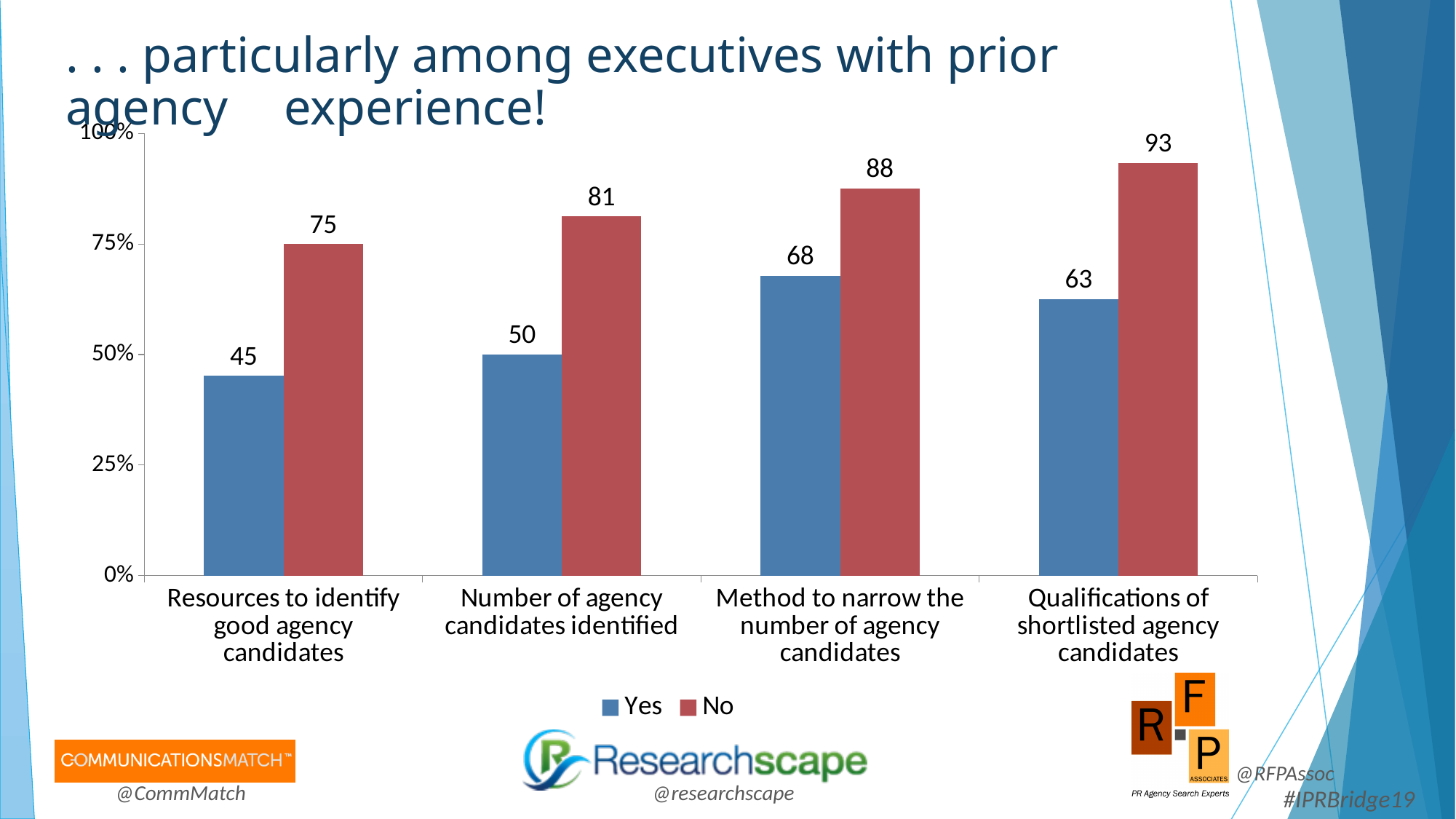
Is the "Yes" value for "Number of agency candidates identified" greater or less than 75%? less What colour are the "No" bars? red How many categories are shown on the x axis? 4 What is the difference between the "No" and "Yes" values for "Number of agency candidates identified"? 31 What is the value for "No" for "Method to narrow the number of agency candidates"? 88 Which category has the highest "Yes" value? Method to narrow the number of agency candidates What is the value for "No" for "Qualifications of shortlisted agency candidates"? 93 How many series does the legend list? 2 What is the value for "Yes" for "Resources to identify good agency candidates"? 45 What kind of chart is shown on the slide? bar chart Which is larger for "Qualifications of shortlisted agency candidates": the "Yes" value or the "No" value? No Which category has the lowest "No" value? Resources to identify good agency candidates